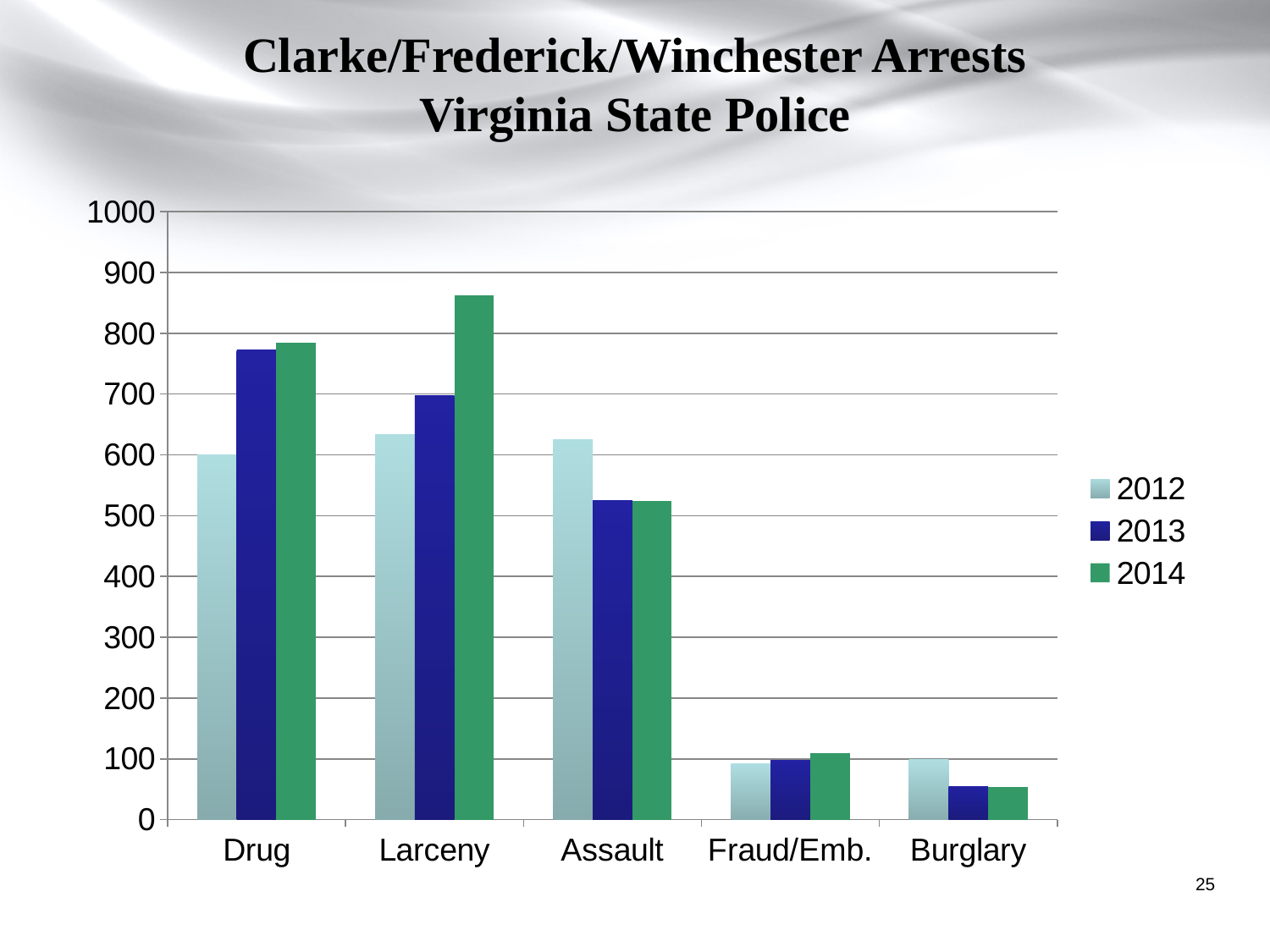
Which category has the lowest value for 2014? Burglary Is the 2014 value for Larceny greater or less than 800? greater For Assault arrests, which year has the larger value, 2012 or 2014? 2012 How many series does the legend list? 3 What are the three entries in the legend? 2012, 2013, 2014 For Drug arrests, which year has the larger value, 2012 or 2013? 2013 Is the 2013 value for Burglary greater or less than 100? less Do Larceny arrests rise or fall from 2012 to 2014? rise Is the 2013 value for Assault greater or less than 600? less What kind of chart is shown on the slide? bar chart Which category and year has the tallest bar in the chart? Larceny, 2014 How many arrest categories are shown on the x axis? 5